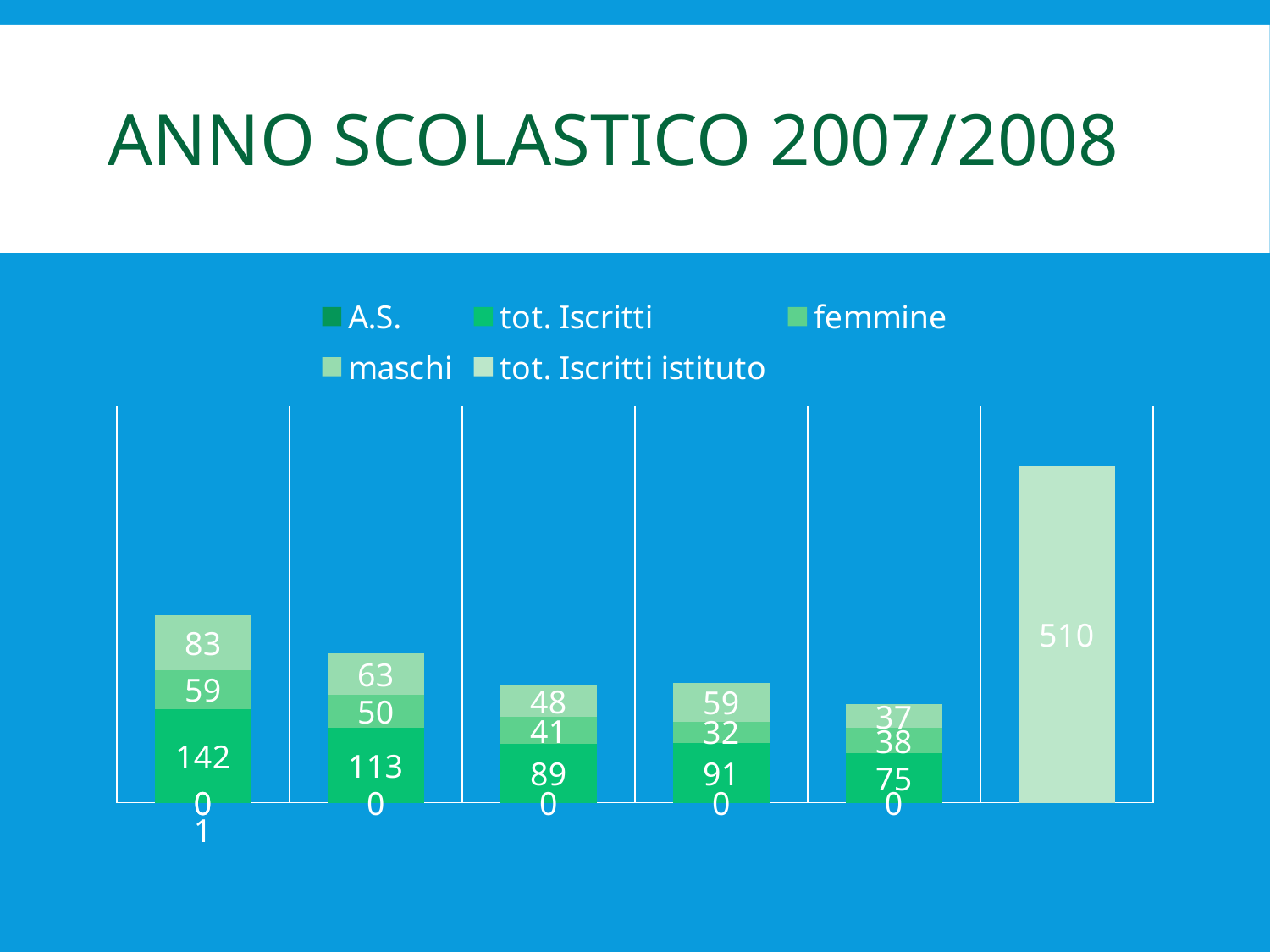
What is the value of the femmine segment in the fourth bar from the left? 32 What is the value of the tot. Iscritti segment in the first bar from the left? 142 What kind of chart is shown on the slide? stacked bar chart What is the title of the slide containing the chart? ANNO SCOLASTICO 2007/2008 What value is printed on the tot. Iscritti istituto bar (the rightmost bar)? 510 In the fifth bar from the left, which is larger, the femmine segment or the maschi segment? femmine (38) What is the total of the femmine and maschi segments in the third bar from the left? 89 How many series does the legend list? 5 What is the value of the maschi segment in the second bar from the left? 63 What is the difference between the tot. Iscritti values of the first and second bars from the left? 29 Which bar has the lowest tot. Iscritti value? the fifth bar from the left (75) Which bar has the highest tot. Iscritti value? the first bar from the left (142)